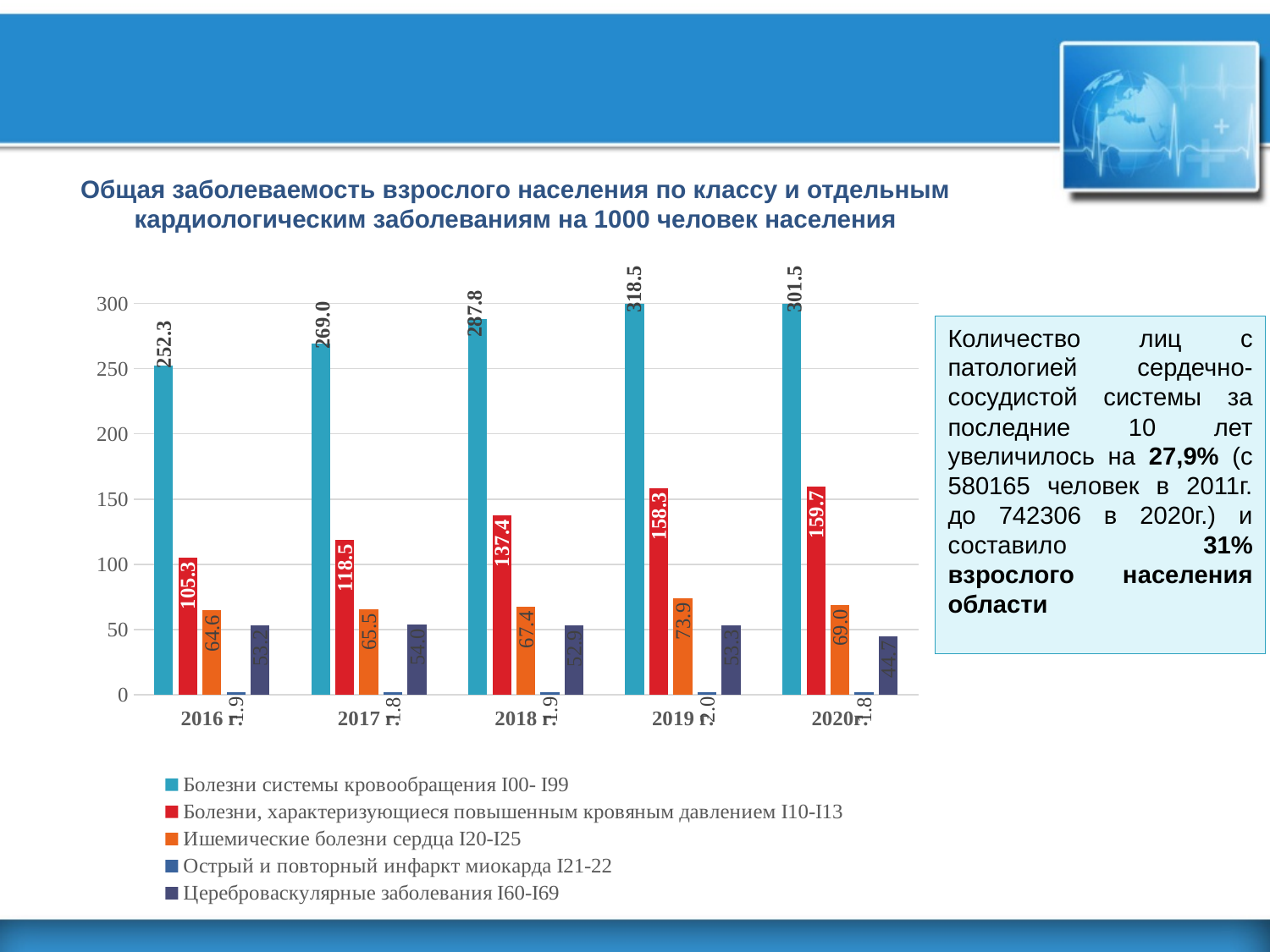
What is the value for Болезни системы кровообращения I00-I99 in 2019 г.? 318.5 What is the difference between the 2019 г. and 2016 г. values for Болезни системы кровообращения I00-I99? 66.2 Which year has the larger value for Ишемические болезни сердца I20-I25, 2019 г. or 2020г.? 2019 г. In which year is the value for Болезни системы кровообращения I00-I99 the highest? 2019 г. What is the value for Ишемические болезни сердца I20-I25 in 2018 г.? 67.4 Do the values for Болезни, характеризующиеся повышенным кровяным давлением I10-I13 rise or fall from 2016 г. to 2020г.? rise What is the value for Болезни, характеризующиеся повышенным кровяным давлением I10-I13 in 2020г.? 159.7 What is the difference between the 2020г. and 2016 г. values for Болезни, характеризующиеся повышенным кровяным давлением I10-I13? 54.4 What kind of chart is shown on the slide? bar chart In which year is the value for Цереброваскулярные заболевания I60-I69 the lowest? 2020г. How many series does the legend list? 5 How many years are shown on the x axis of the chart? 5